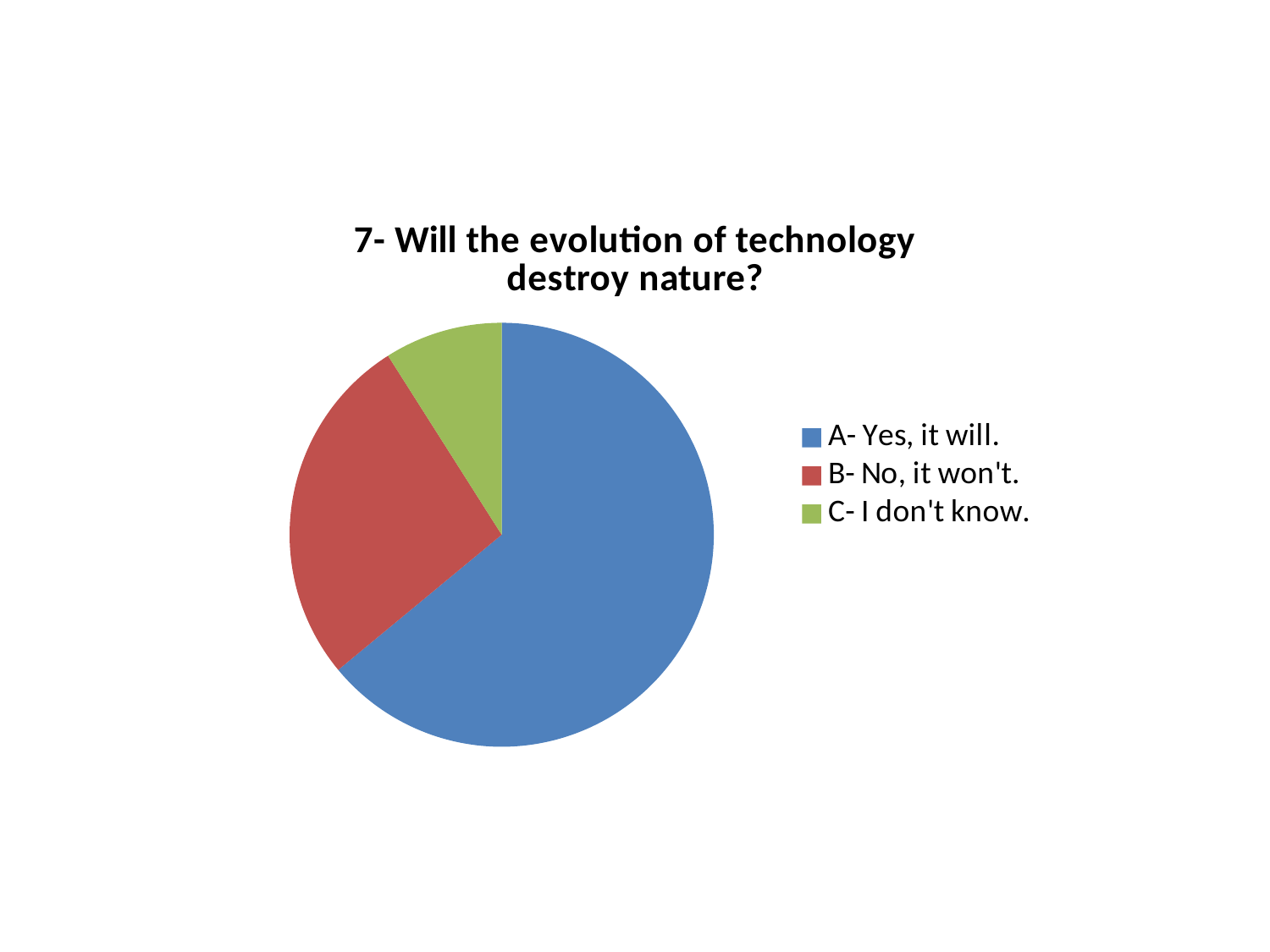
How many slices does the pie chart have? 3 Which colour represents "C- I don't know." in the pie chart? green How many entries does the legend list? 3 Which category has the largest slice of the pie? A- Yes, it will. Which category has the smallest slice of the pie? C- I don't know. Which slice is larger, "A- Yes, it will." or "B- No, it won't."? A- Yes, it will. What is the title of the chart? 7- Will the evolution of technology destroy nature? Which slice is larger, "B- No, it won't." or "C- I don't know."? B- No, it won't. Does the slice for "A- Yes, it will." take up more or less than half of the pie? more What kind of chart is shown on the slide? pie chart